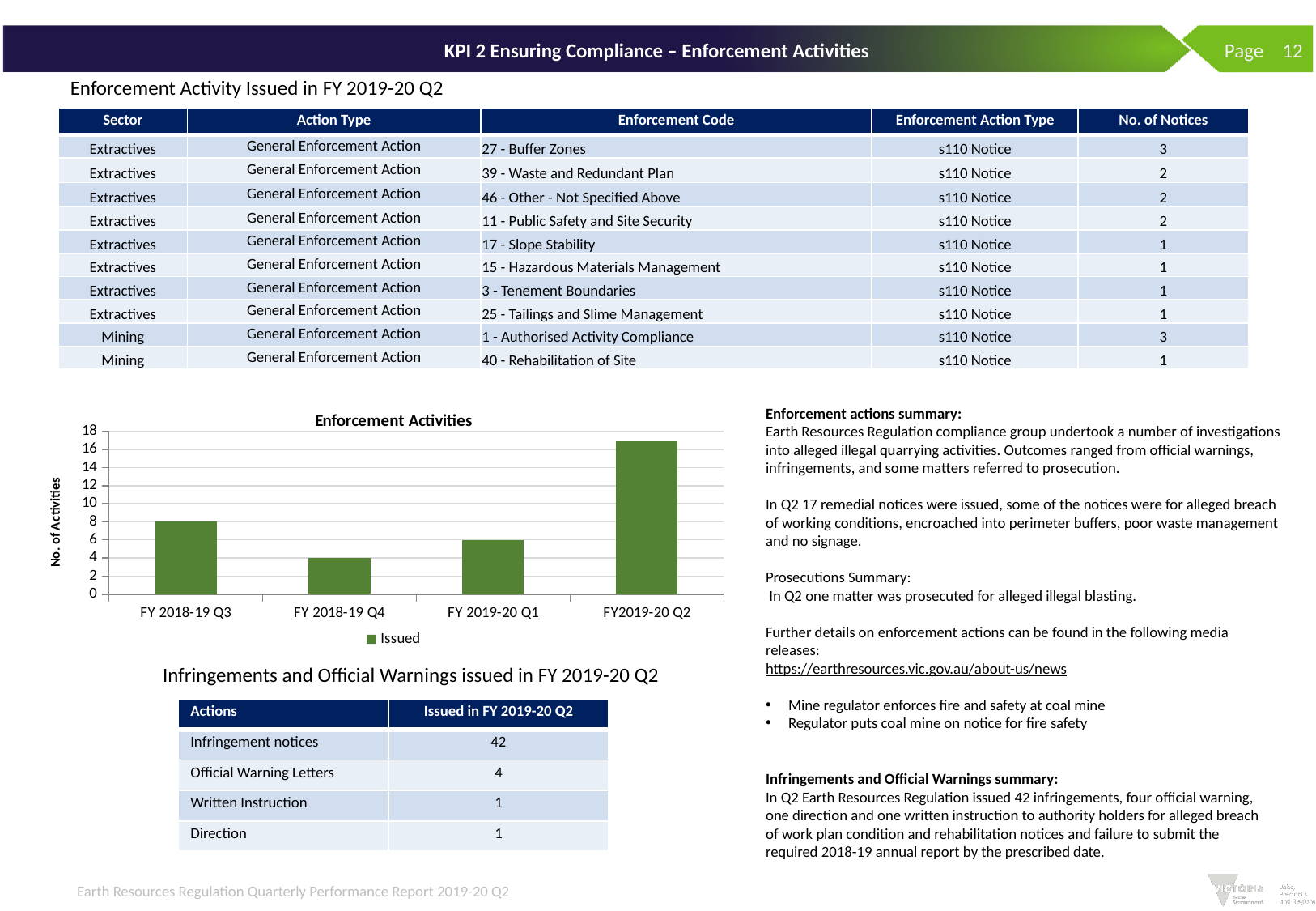
In the Enforcement Activities chart, which quarter has the lowest number of activities? FY 2018-19 Q4 How many series does the legend of the Enforcement Activities chart list? 1 In the Enforcement Activities chart, what is the value for FY 2018-19 Q3? 8 In the Enforcement Activities chart, how many quarters are shown on the x axis? 4 In the Enforcement Activities chart, what is the difference between the values for FY 2018-19 Q3 and FY 2018-19 Q4? 4 What is the label on the y axis of the Enforcement Activities chart? No. of Activities In the Enforcement Activities chart, which is larger: the value for FY 2018-19 Q3 or FY 2019-20 Q1? FY 2018-19 Q3 In the Enforcement Activities chart, is the value for FY2019-20 Q2 greater or less than 16? greater What type of chart is the Enforcement Activities chart? bar chart In the Enforcement Activities chart, which quarter has the highest number of activities? FY2019-20 Q2 In the Enforcement Activities chart, what is the value for FY 2019-20 Q1? 6 In the Enforcement Activities chart, what is the value for FY 2018-19 Q4? 4